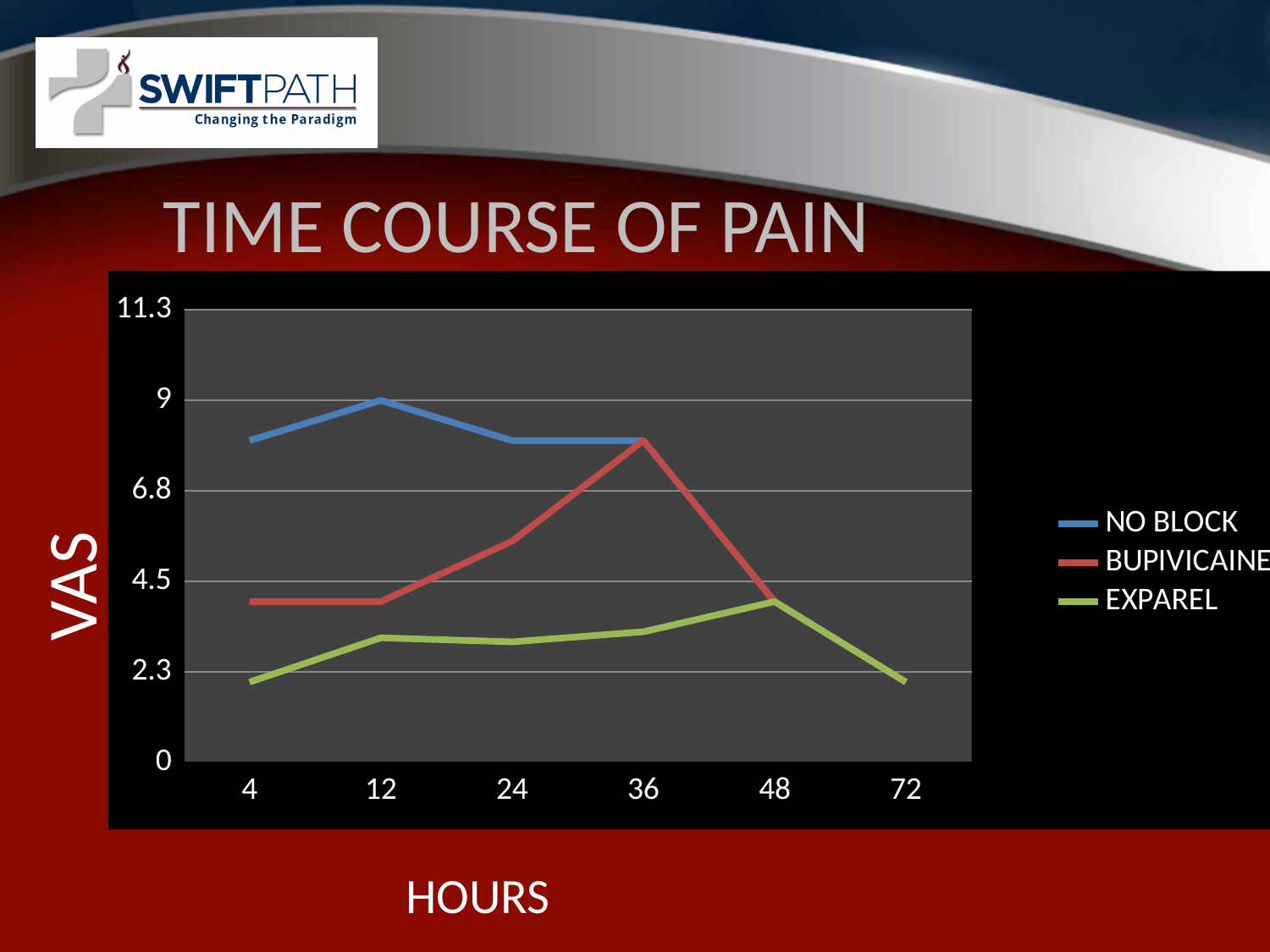
At 24 hours, which series has the higher value, BUPIVICAINE or EXPAREL? BUPIVICAINE What kind of chart is shown on the slide? line chart How many series does the legend list? 3 How many time points are shown on the x axis? 6 Is the NO BLOCK value at 4 hours greater or less than 6.8? greater At which hour does the BUPIVICAINE series reach its highest value? 36 What is the label on the y axis? VAS Is the BUPIVICAINE value at 4 hours greater or less than 4.5? less What is the title of the chart? TIME COURSE OF PAIN Is the EXPAREL value at 72 hours greater or less than 2.3? less At which hour does the NO BLOCK series reach its highest value? 12 Does the BUPIVICAINE series rise or fall between 36 and 48 hours? fall